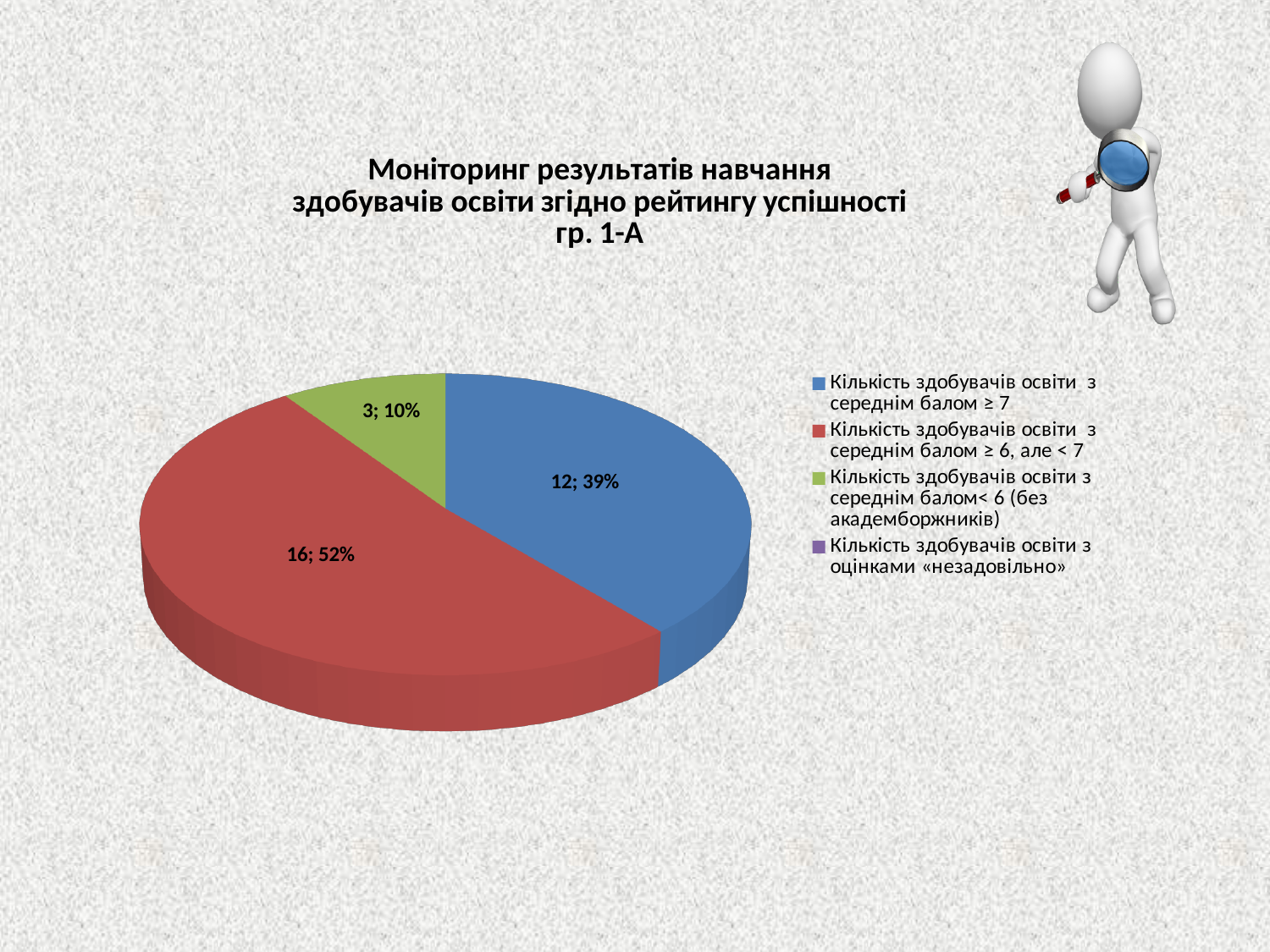
What colour is the slice for students with an average score ≥ 7? blue What share of the pie is the slice for students with an average score < 6? 10% What kind of chart is shown on the slide? pie chart How many students have an average score < 6 (без академборжників)? 3 Which visible slice of the pie is the smallest? Кількість здобувачів освіти з середнім балом< 6 (без академборжників) How many students have an average score ≥ 6 but < 7? 16 Which category has the largest slice of the pie? Кількість здобувачів освіти з середнім балом ≥ 6, але < 7 How many entries does the legend list? 4 What share of the pie is the slice for students with an average score ≥ 6 but < 7? 52% How many students have an average score ≥ 7 (Кількість здобувачів освіти з середнім балом ≥ 7)? 12 What is the difference between the number of students with an average score ≥ 6 but < 7 and those with an average score ≥ 7? 4 What share of the pie is the slice for students with an average score ≥ 7? 39%